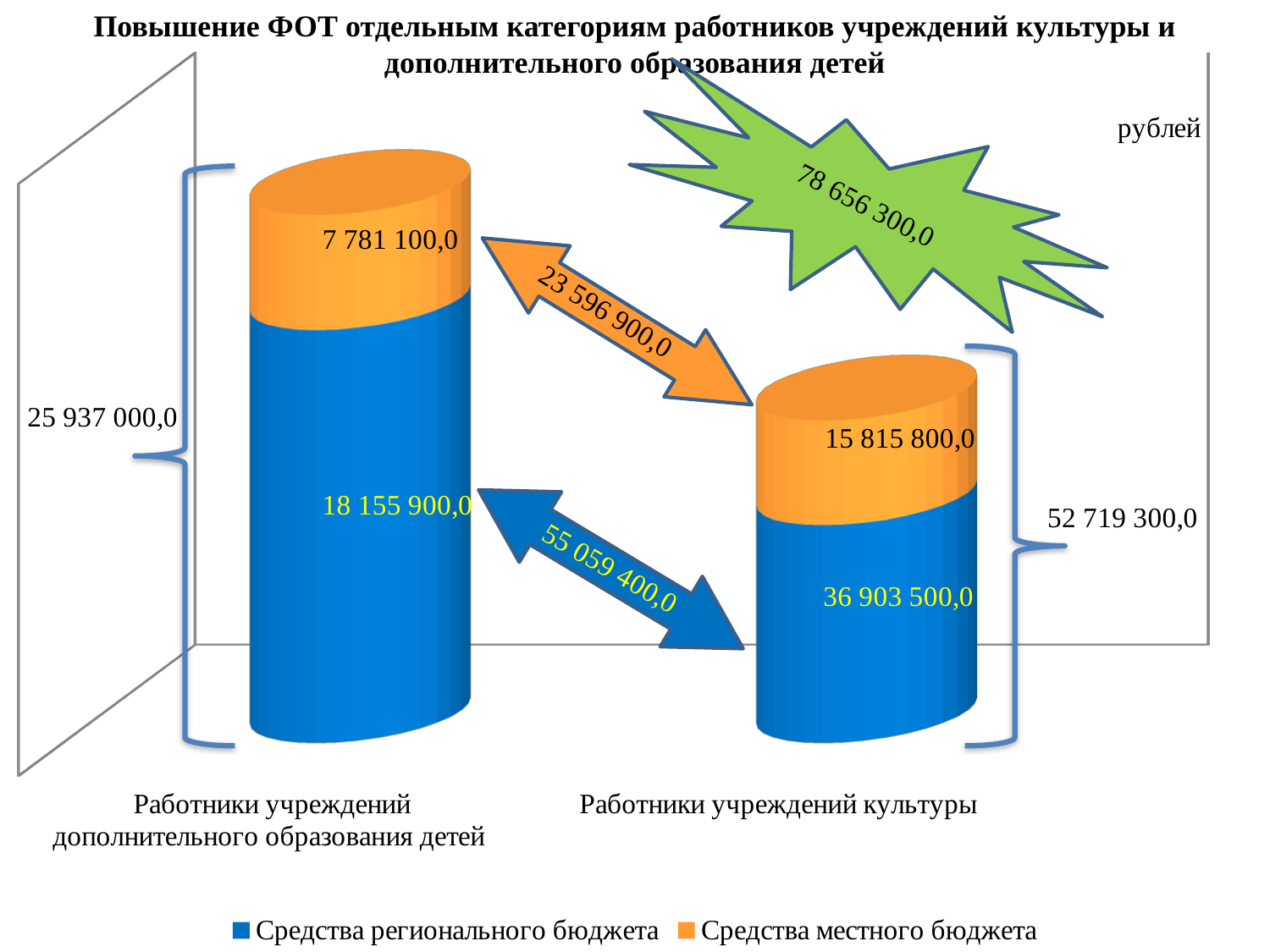
Which category has the lower value for Средства местного бюджета? Работники учреждений дополнительного образования детей Which category has the higher value for Средства регионального бюджета? Работники учреждений культуры What is the total of the stacked bar for Работники учреждений дополнительного образования детей? 25 937 000,0 How many categories are shown on the x axis? 2 What is the total of the stacked bar for Работники учреждений культуры? 52 719 300,0 What kind of chart is shown on the slide? Stacked bar chart How many series does the legend list? 2 What is the difference between the Средства регионального бюджета values for Работники учреждений культуры and Работники учреждений дополнительного образования детей? 18 747 600,0 What is the value of Средства местного бюджета for Работники учреждений культуры? 15 815 800,0 What is the value of Средства местного бюджета for Работники учреждений дополнительного образования детей? 7 781 100,0 What is the value of Средства регионального бюджета for Работники учреждений дополнительного образования детей? 18 155 900,0 What is the value of Средства регионального бюджета for Работники учреждений культуры? 36 903 500,0